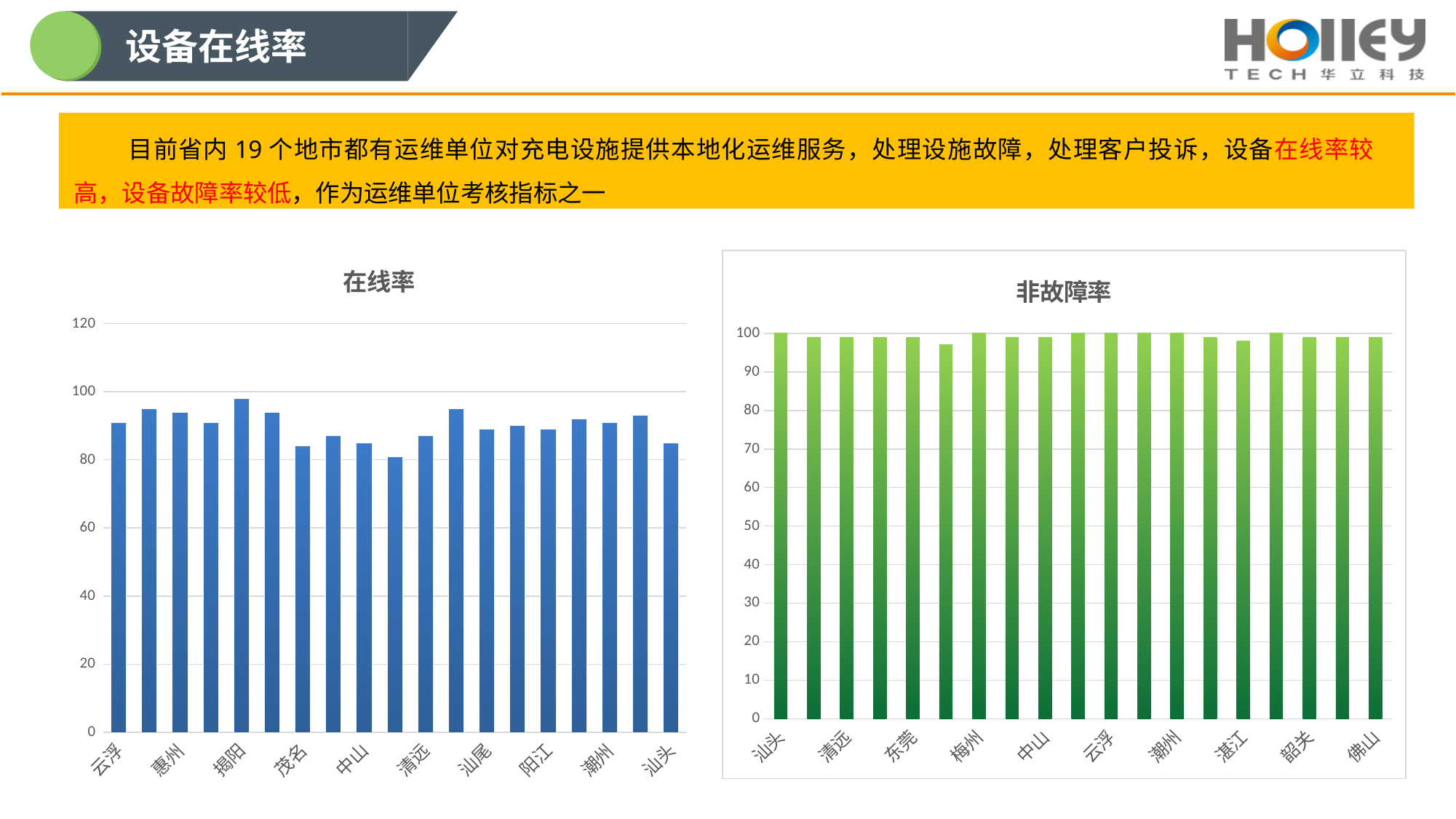
In the 非故障率 chart, is the value for 湛江 greater or less than 90? greater In the 在线率 chart, is the value for 揭阳 greater or less than 90? greater How many bars are plotted in the 非故障率 chart? 19 In the 在线率 chart, which is larger, the value for 汕尾 or the value for 汕头? 汕尾 In the 在线率 chart, is the value for 汕头 greater or less than 90? less What kind of chart is the 在线率 chart on the left? bar chart In the 在线率 chart, which is larger, the value for 揭阳 or the value for 茂名? 揭阳 What kind of chart is the 非故障率 chart on the right? bar chart What is the title of the chart on the right side of the slide? 非故障率 How many bars are plotted in the 在线率 chart? 19 In the 在线率 chart, which labelled city has the highest bar? 揭阳